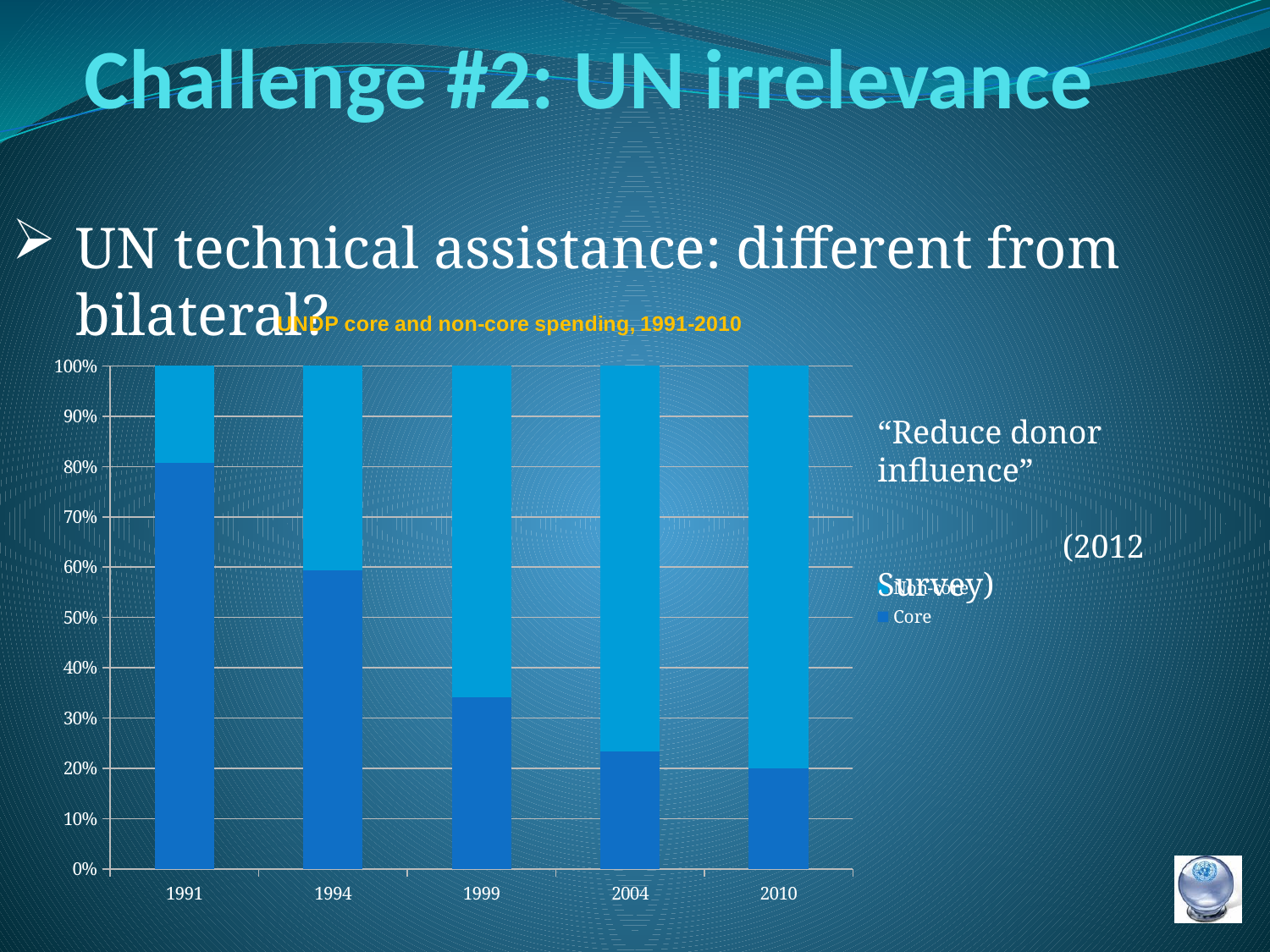
How many series does the chart's legend list? 2 What is the title of the chart? UNDP core and non-core spending, 1991-2010 Does the Core share rise or fall from 1991 to 2010? fall How many years are shown on the x axis of the chart? 5 What kind of chart is shown on the slide? bar chart What is the total height of the stacked bar for 1994? 100% Is the Core share for 2004 greater or less than 30%? less Is the Core share for 1991 greater or less than 70%? greater In which year is the Core share the highest? 1991 Is the Core share for 1999 greater or less than 40%? less Which year has the larger Core share, 1991 or 1999? 1991